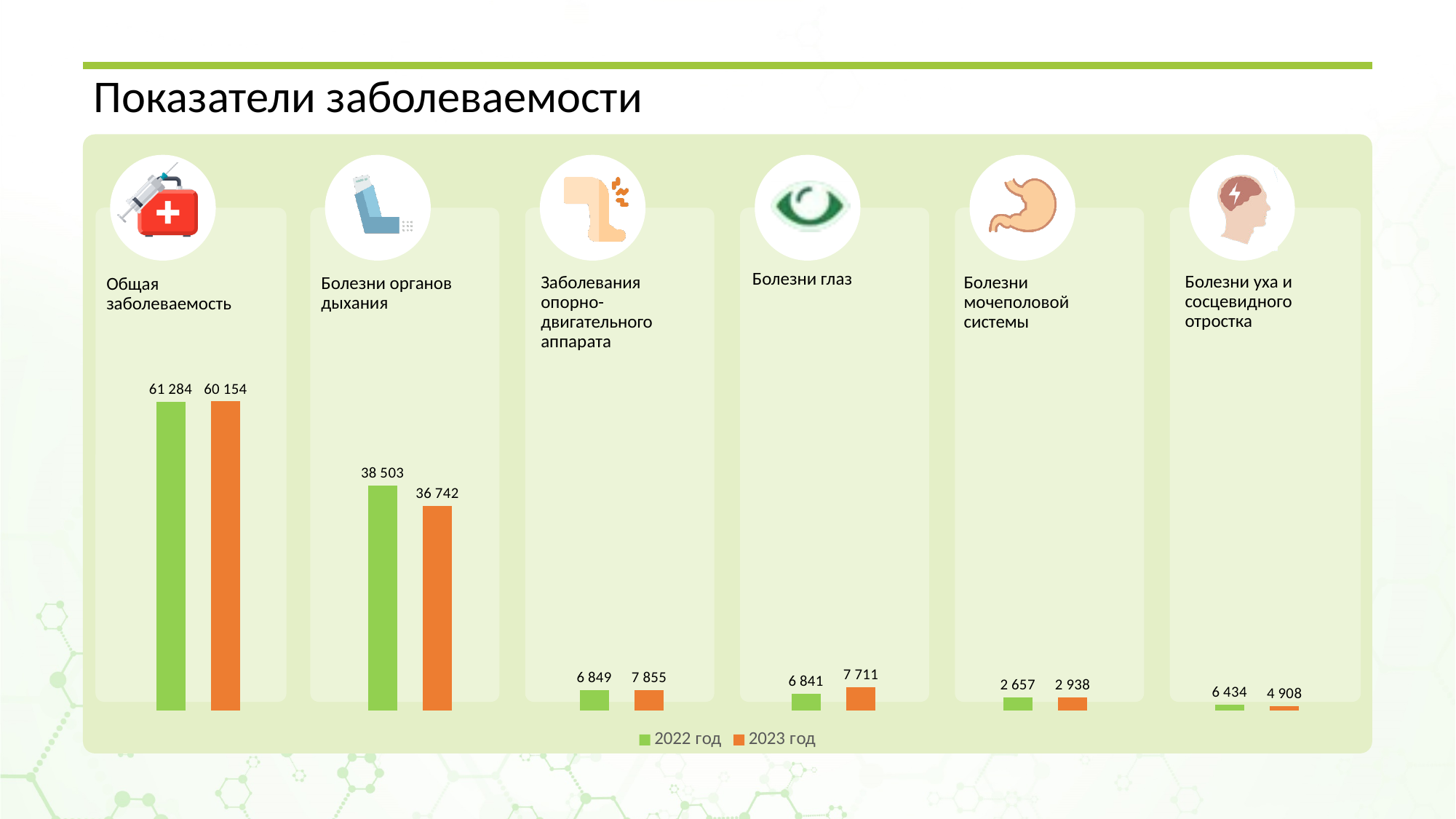
What is the value for Болезни глаз in 2023 год? 7 711 Which category has the highest value in 2022 год? Общая заболеваемость How many categories are shown in the chart? 6 What is the value for Общая заболеваемость in 2022 год? 61 284 What is the value for Болезни уха и сосцевидного отростка in 2022 год? 6 434 What is the value for Болезни органов дыхания in 2023 год? 36 742 Which category has the lowest value in 2023 год? Болезни мочеполовой системы What is the difference between the 2022 год and 2023 год values for Общая заболеваемость? 1 130 How many series does the legend list? 2 Which is larger for Болезни мочеполовой системы: the 2022 год value or the 2023 год value? 2023 год What is the difference between the 2023 год and 2022 год values for Заболевания опорно-двигательного аппарата? 1 006 What type of chart is shown on the slide? Bar chart